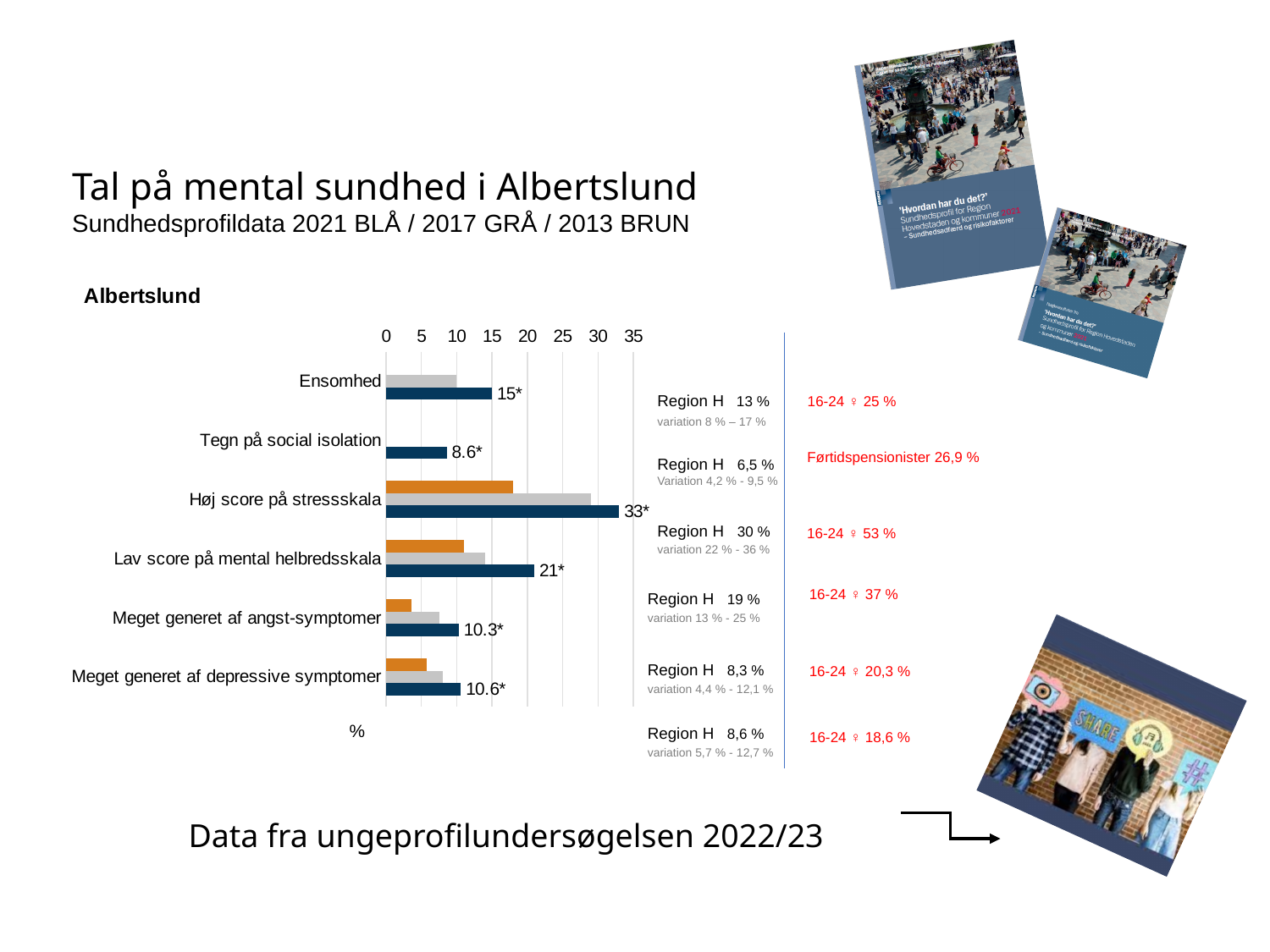
Is the 2017 (grey) value for Høj score på stressskala greater or less than 25? greater What is the 2021 (blue) value shown for Høj score på stressskala? 33* What kind of chart is shown on the slide? bar chart According to the slide, which colour represents the 2021 data? Blue (BLÅ) How many categories are shown on the chart? 6 Which category has the highest 2021 (blue) value? Høj score på stressskala Which has the larger 2021 (blue) value: Ensomhed or Lav score på mental helbredsskala? Lav score på mental helbredsskala What is the difference between the 2021 values for Høj score på stressskala and Lav score på mental helbredsskala? 12 What is the 2021 (blue) value shown for Ensomhed? 15* Which category has the lowest 2021 (blue) value? Tegn på social isolation What is the 2021 (blue) value shown for Tegn på social isolation? 8.6* Is the 2013 (brown) value for Meget generet af angst-symptomer greater or less than 5? less